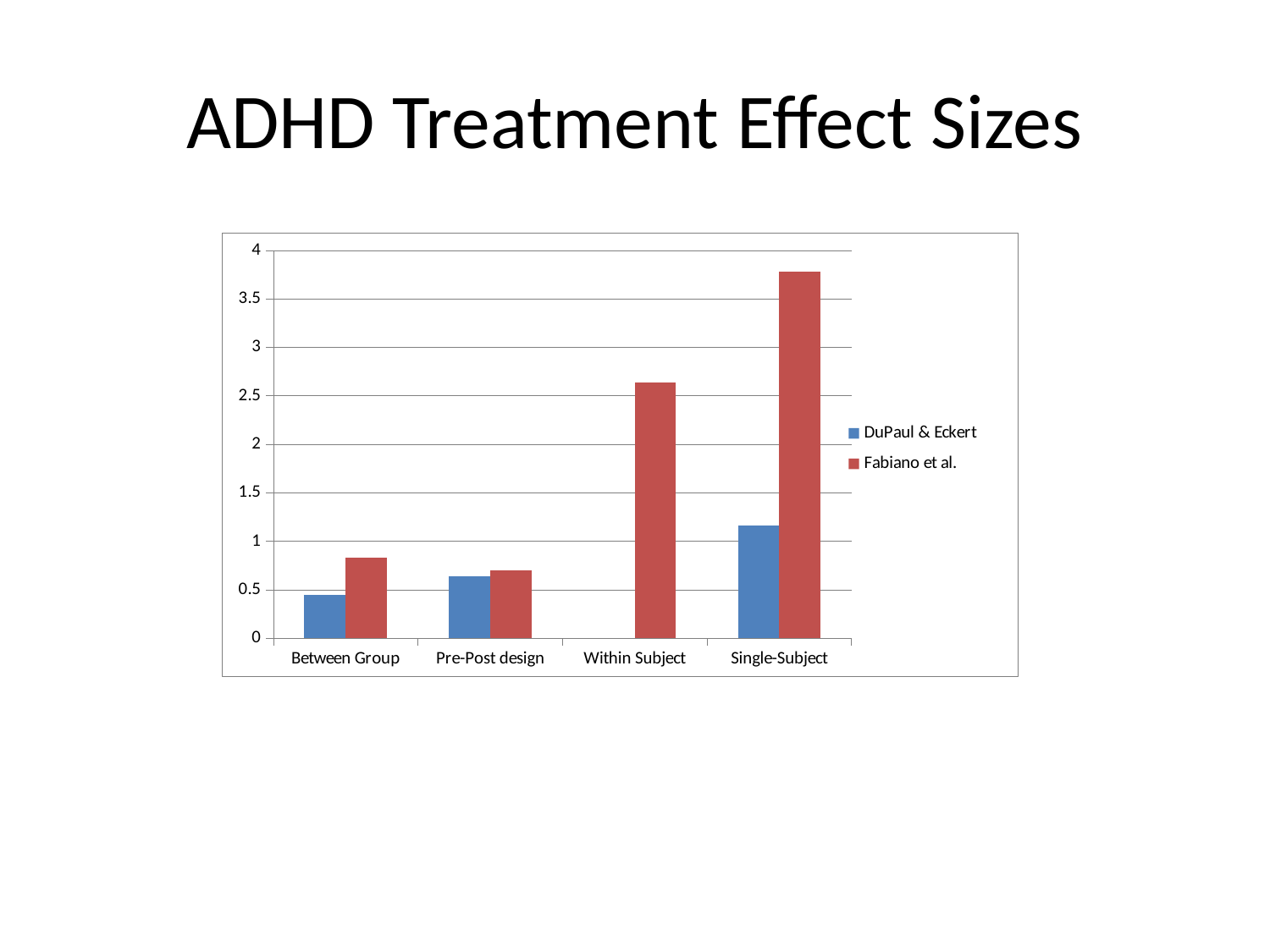
Is the Fabiano et al. value for Within Subject greater or less than 2? greater How many categories are shown on the x axis? 4 Is the Fabiano et al. value for Single-Subject greater or less than 3.5? greater Is the DuPaul & Eckert value for Single-Subject greater or less than 1? greater What kind of chart is shown on the slide? bar chart Which category has the highest value for DuPaul & Eckert? Single-Subject For Between Group, which series has the larger value, DuPaul & Eckert or Fabiano et al.? Fabiano et al. Which category has the lowest value for Fabiano et al.? Pre-Post design Which category has the highest value for Fabiano et al.? Single-Subject How many series does the legend list? 2 What is the title of the slide containing the chart? ADHD Treatment Effect Sizes